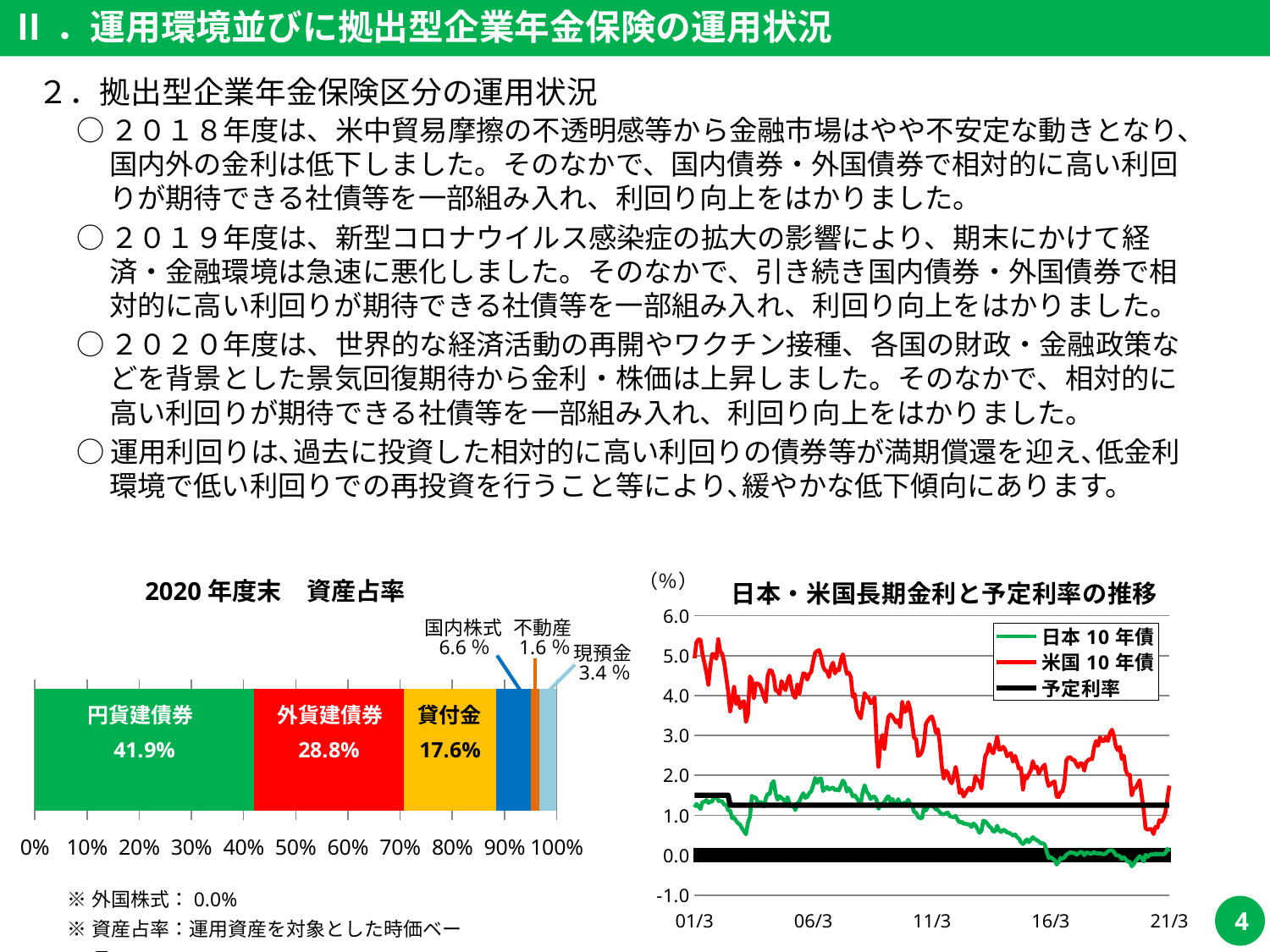
In the 2020年度末 資産占率 chart, what share is shown for 貸付金? 17.6% In the 日本・米国長期金利と予定利率の推移 chart, does the 予定利率 line rise or fall from 01/3 to 21/3? fall In the 2020年度末 資産占率 chart, what share is shown for 円貨建債券? 41.9% In the 2020年度末 資産占率 chart, which labeled segment has the smallest share? 不動産 In the 2020年度末 資産占率 chart, how many percentage points larger is 円貨建債券 than 外貨建債券? 13.1% In the 2020年度末 資産占率 chart, which asset category has the largest share? 円貨建債券 What kind of chart is the 2020年度末 資産占率 chart? Bar chart In the 日本・米国長期金利と予定利率の推移 chart, how many series does the legend list? 3 In the 2020年度末 資産占率 chart, how many asset segments are plotted in the bar? 6 In the 2020年度末 資産占率 chart, which is larger, 国内株式 or 現預金? 国内株式 In the 日本・米国長期金利と予定利率の推移 chart, is the value of 米国10年債 at 01/3 greater or less than 4.0? greater In the 2020年度末 資産占率 chart, what share is shown for 外貨建債券? 28.8%